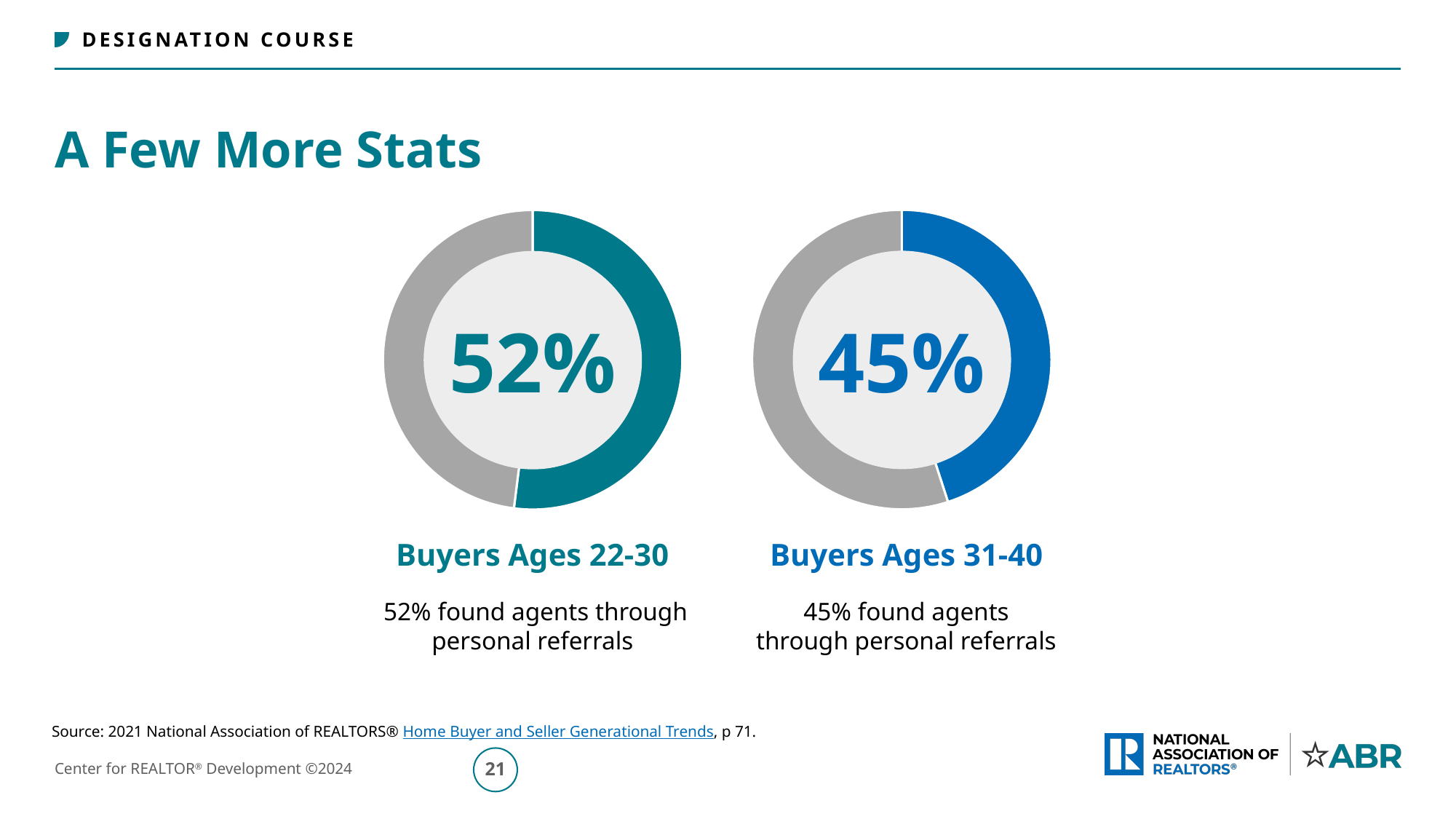
What is the difference in percentage points between the Buyers Ages 22-30 chart and the Buyers Ages 31-40 chart? 7 percentage points What is the title of the slide containing the two donut charts? A Few More Stats What kind of chart is used to show the percentages on this slide? Donut (pie) chart Is the value shown in the Buyers Ages 22-30 chart greater or less than 50%? greater Is the value shown in the Buyers Ages 31-40 chart greater or less than 50%? less Is the value for Buyers Ages 22-30 larger or smaller than the value for Buyers Ages 31-40? larger How many donut charts are shown on the slide? 2 In the right chart (Buyers Ages 31-40), what percentage found agents through personal referrals? 45% In the left chart (Buyers Ages 22-30), what percentage found agents through personal referrals? 52% What colour is the highlighted segment in the Buyers Ages 31-40 chart? Blue Which buyer age group has the higher share of buyers who found agents through personal referrals? Buyers Ages 22-30 Which buyer age group has the lower share of buyers who found agents through personal referrals? Buyers Ages 31-40